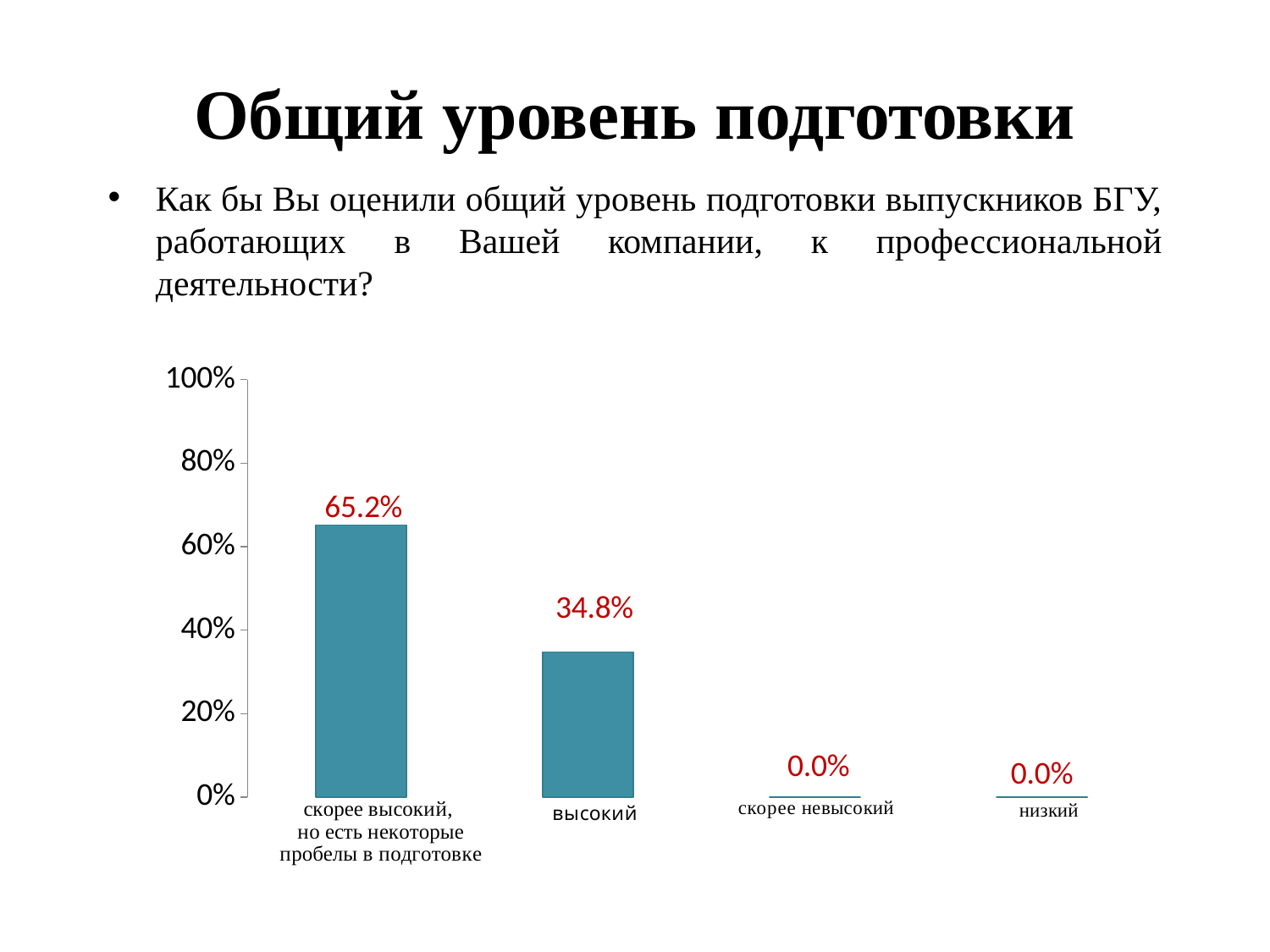
What is the highest value shown on the vertical axis? 100% What is the value for the category "скорее высокий, но есть некоторые пробелы в подготовке"? 65.2% How many categories are shown on the chart? 4 What is the value for the category "скорее невысокий"? 0.0% Is the value for "высокий" greater or less than 40%? less Which category has the highest value? скорее высокий, но есть некоторые пробелы в подготовке What is the value for the category "низкий"? 0.0% What is the value for the category "высокий"? 34.8% What kind of chart is shown on the slide? bar chart Which is larger, the value for "высокий" or the value for "скорее высокий, но есть некоторые пробелы в подготовке"? скорее высокий, но есть некоторые пробелы в подготовке Is the value for "скорее высокий, но есть некоторые пробелы в подготовке" greater or less than 60%? greater What is the difference between the values for "скорее высокий, но есть некоторые пробелы в подготовке" and "высокий"? 30.4%